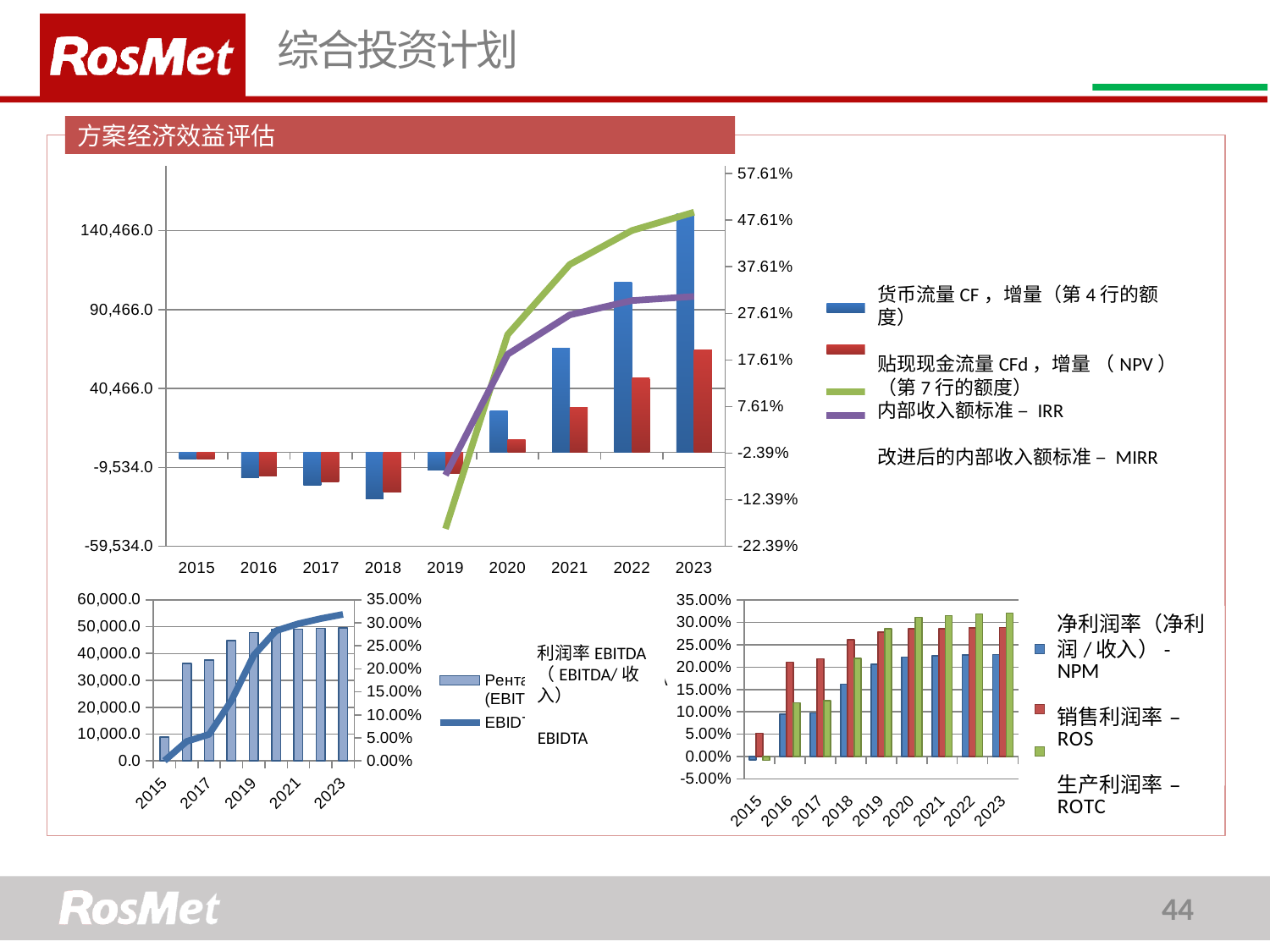
In the bottom-right chart, how many series does the legend list? 3 In the top chart, which year has the lowest blue bar (货币流量 CF, 增量)? 2018 In the top chart, does the green line (改进后的内部收入额标准 – MIRR) rise or fall from 2019 to 2023? rise In the top chart, how many years are shown on the x axis? 9 In the top chart, is the blue bar (货币流量 CF, 增量) for 2022 greater or less than 90,466.0? greater In the bottom-right chart, is the value for 净利润率 NPM in 2015 greater or less than 0.00%? less In the top chart, how many series does the legend list? 4 In the top chart, which year has the highest blue bar (货币流量 CF, 增量)? 2023 What kind of chart is the bottom-right chart? bar chart In the top chart, which is larger in 2021: the blue bar (货币流量 CF) or the red bar (贴现现金流量 CFd)? the blue bar (货币流量 CF) In the bottom-right chart, is the value for 净利润率 NPM in 2020 greater or less than 20.00%? greater